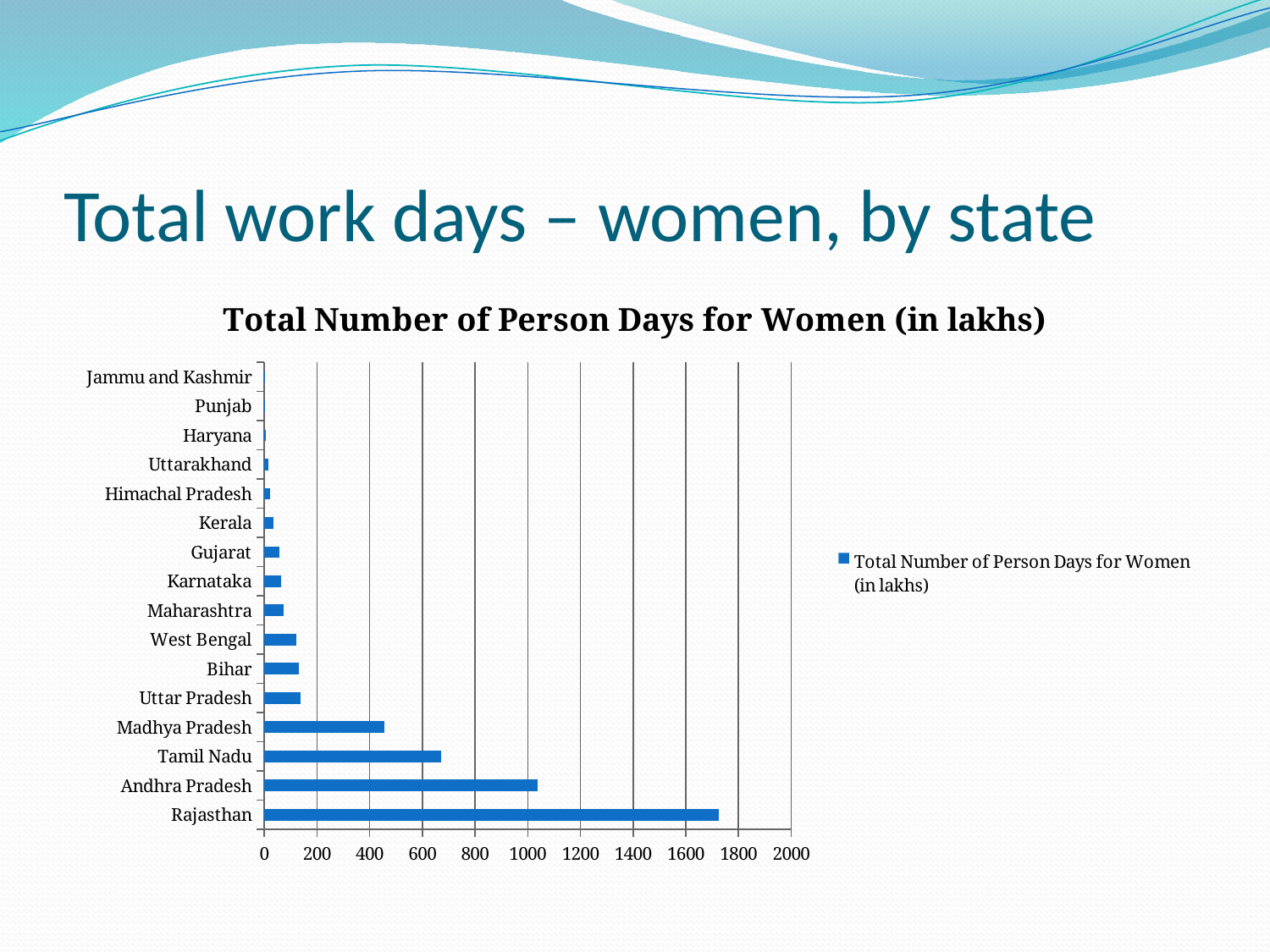
Which has a larger value, Andhra Pradesh or Tamil Nadu? Andhra Pradesh How many series does the legend list? 1 What kind of chart is shown on the slide? bar chart Is the value for Uttar Pradesh greater or less than 200? less Is the value for Rajasthan greater or less than 1600? greater Which state has the highest total number of person days for women? Rajasthan Is the value for Andhra Pradesh greater or less than 1200? less How many states are shown on the chart? 16 Which has a larger value, Tamil Nadu or Madhya Pradesh? Tamil Nadu What is the title of the chart? Total Number of Person Days for Women (in lakhs)